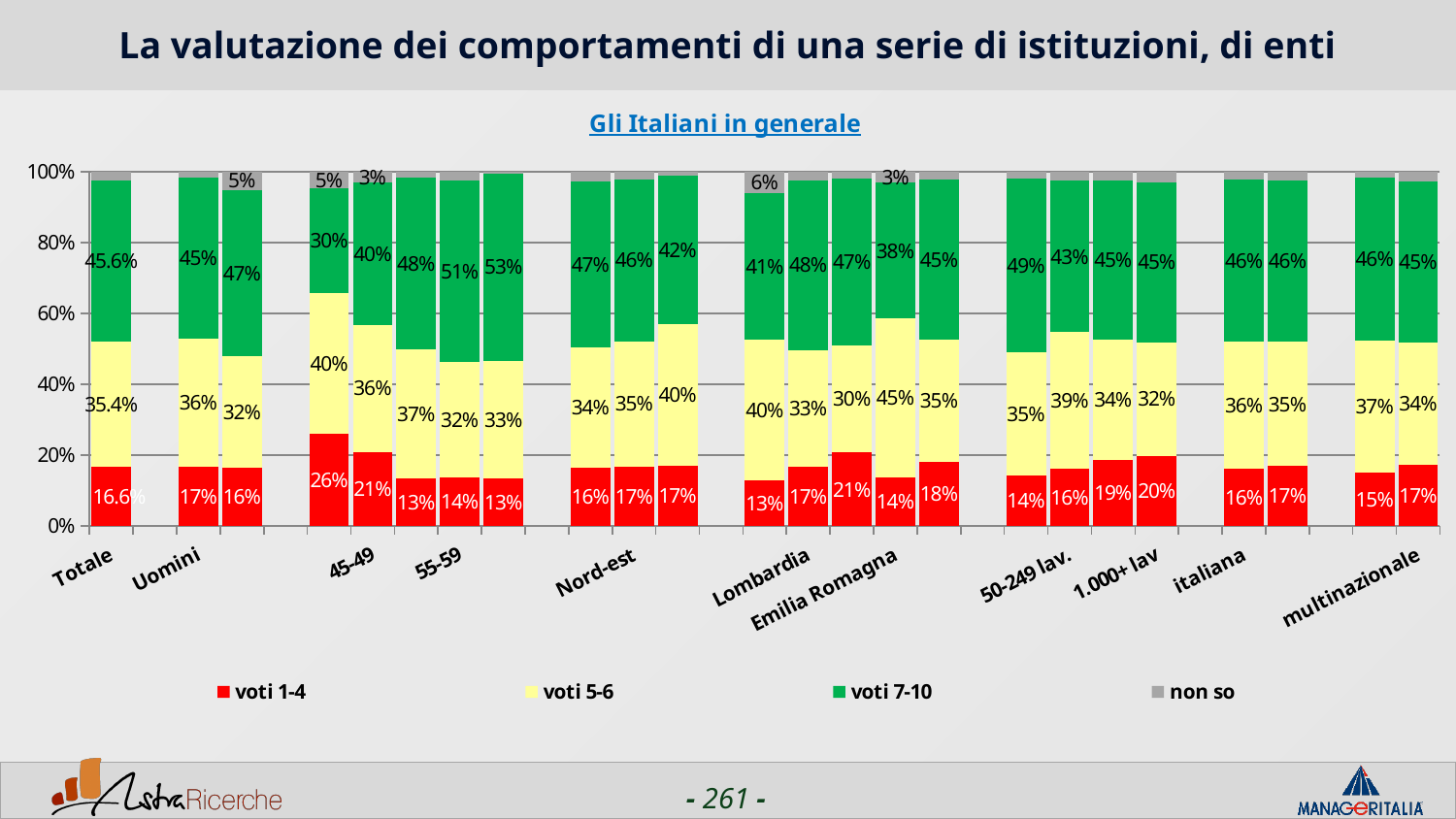
For Uomini, what is the difference between 'voti 7-10' and 'voti 1-4'? 28 percentage points How many series does the legend list? 4 What is the value of 'voti 1-4' for Totale? 16.6% For Totale, which is larger: 'voti 7-10' or 'voti 5-6'? voti 7-10 What is the subtitle shown above the chart? Gli Italiani in generale Is the value of 'voti 1-4' for Uomini greater or less than 20%? less What is the first entry in the chart legend? voti 1-4 What is the value of 'voti 7-10' for Uomini? 45% What is the value of 'voti 7-10' for Totale? 45.6% What kind of chart is shown on the slide? stacked bar chart What is the value of 'voti 5-6' for Uomini? 36% What is the value of 'voti 5-6' for Totale? 35.4%